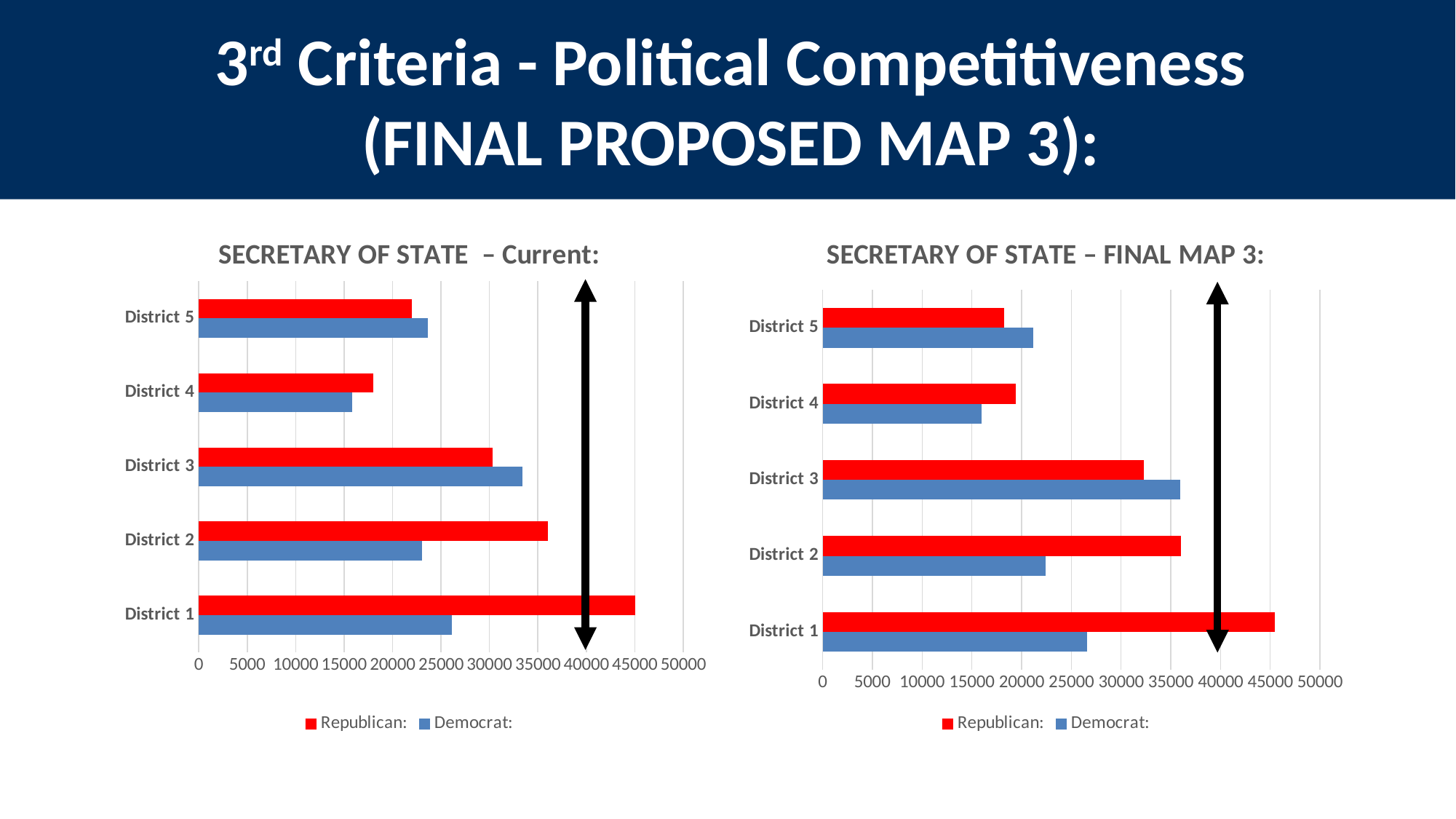
In the 'SECRETARY OF STATE – FINAL MAP 3:' chart, is the Democrat value for District 4 greater or less than 20000? less In the 'SECRETARY OF STATE – FINAL MAP 3:' chart, how many series does the legend list? 2 In the 'SECRETARY OF STATE – FINAL MAP 3:' chart, is the Republican value for District 1 greater or less than 40000? greater In the 'SECRETARY OF STATE – FINAL MAP 3:' chart, which district has the highest Democrat value? District 3 What kind of chart is the 'SECRETARY OF STATE – Current:' chart on the left? bar chart In the 'SECRETARY OF STATE – Current:' chart, which district has the highest Republican value? District 1 In the 'SECRETARY OF STATE – FINAL MAP 3:' chart, which district has the lowest Democrat value? District 4 In the 'SECRETARY OF STATE – FINAL MAP 3:' chart, which colour represents the Republican series? red In the 'SECRETARY OF STATE – Current:' chart, for District 2, which is larger, the Republican or the Democrat value? Republican In the 'SECRETARY OF STATE – Current:' chart, is the Republican value for District 1 greater or less than 40000? greater In the 'SECRETARY OF STATE – Current:' chart, which district has the lowest Republican value? District 4 In the 'SECRETARY OF STATE – Current:' chart, how many districts are shown? 5